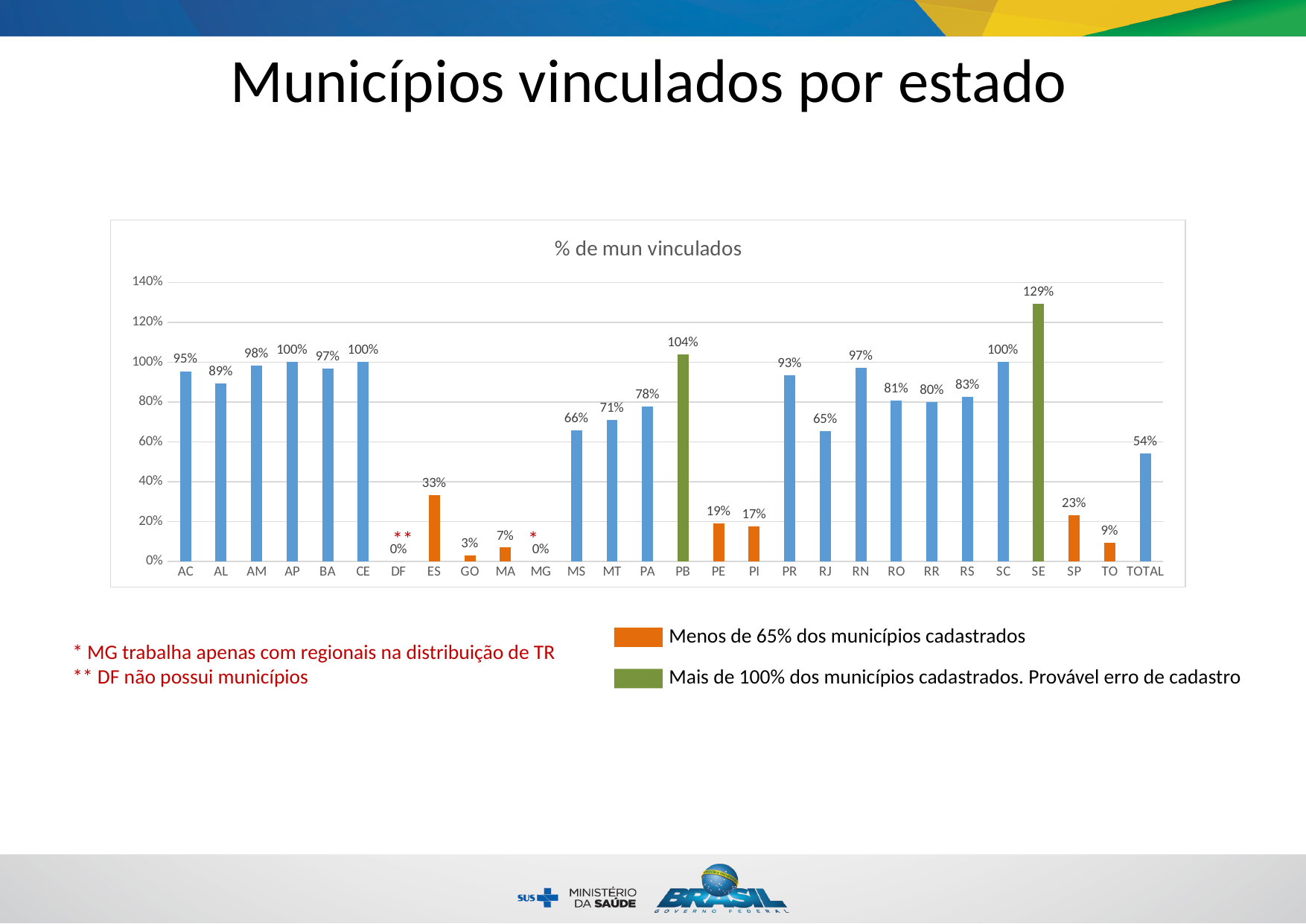
What is the value shown for ES? 33% What is the value for TOTAL in the chart? 54% What is the title of the chart? % de mun vinculados What is the difference between the values for ES and SP? 10 percentage points Is the value for TOTAL greater or less than 60%? less How many categories are shown on the x axis of the chart? 28 Which has a larger value, RN or PR? RN What percentage of municipalities is shown for PB? 104% Which state has the highest value in the chart? SE What kind of chart is shown on the slide? Bar chart Which has a larger value, MT or MS? MT What is the difference between the values for SE and PB? 25 percentage points